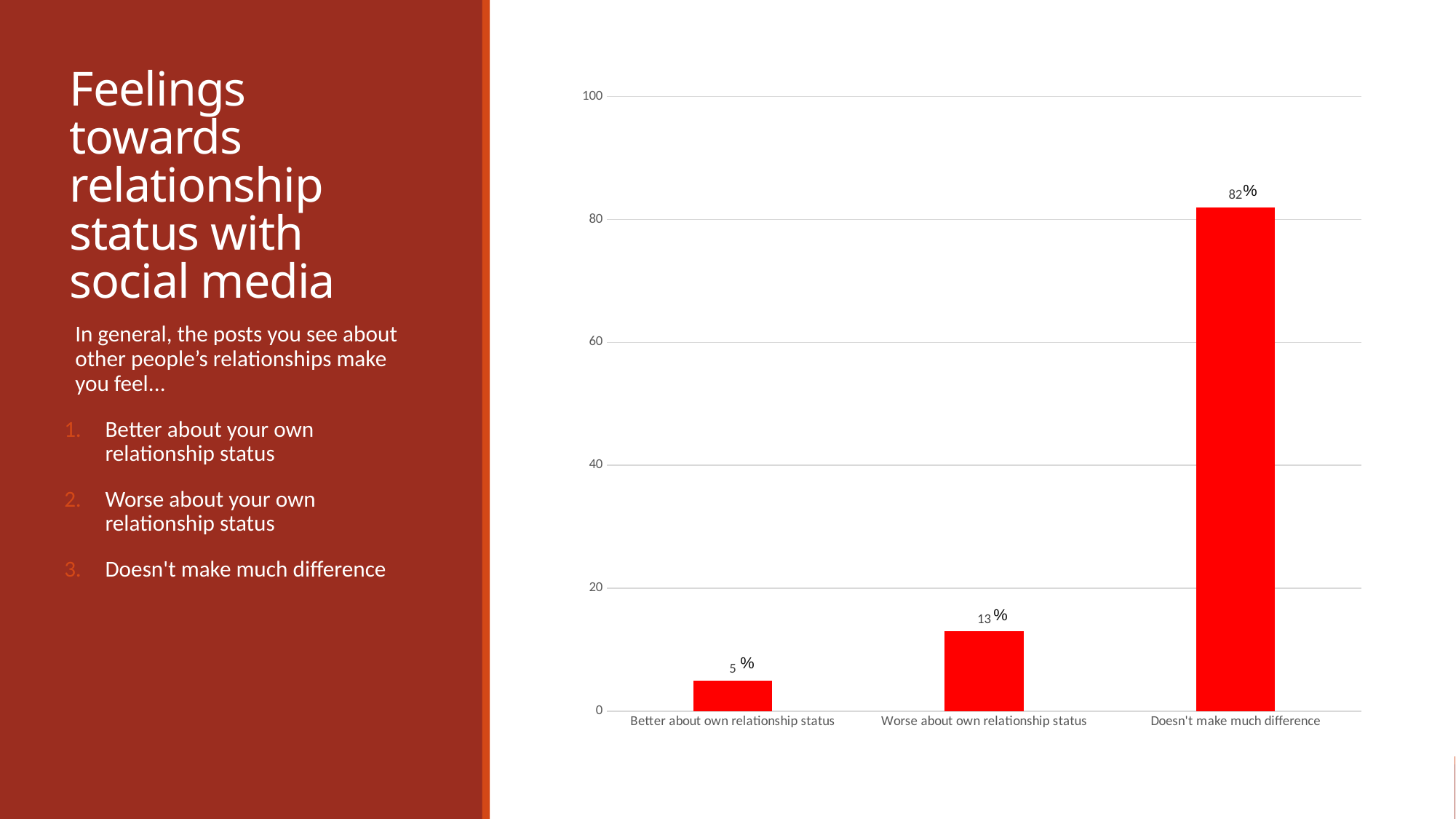
What is the difference between the values for "Worse about own relationship status" and "Better about own relationship status"? 8% Which is larger: the value for "Worse about own relationship status" or "Better about own relationship status"? Worse about own relationship status What is the value for "Worse about own relationship status"? 13% What kind of chart is shown on the slide? bar chart What is the difference between the values for "Doesn't make much difference" and "Worse about own relationship status"? 69% What is the value for "Better about own relationship status"? 5% How many categories are shown on the chart? 3 Is the value for "Doesn't make much difference" greater or less than 80? greater What is the value for "Doesn't make much difference"? 82% Which category has the lowest value? Better about own relationship status What colour are the bars in the chart? red Which category has the highest value? Doesn't make much difference